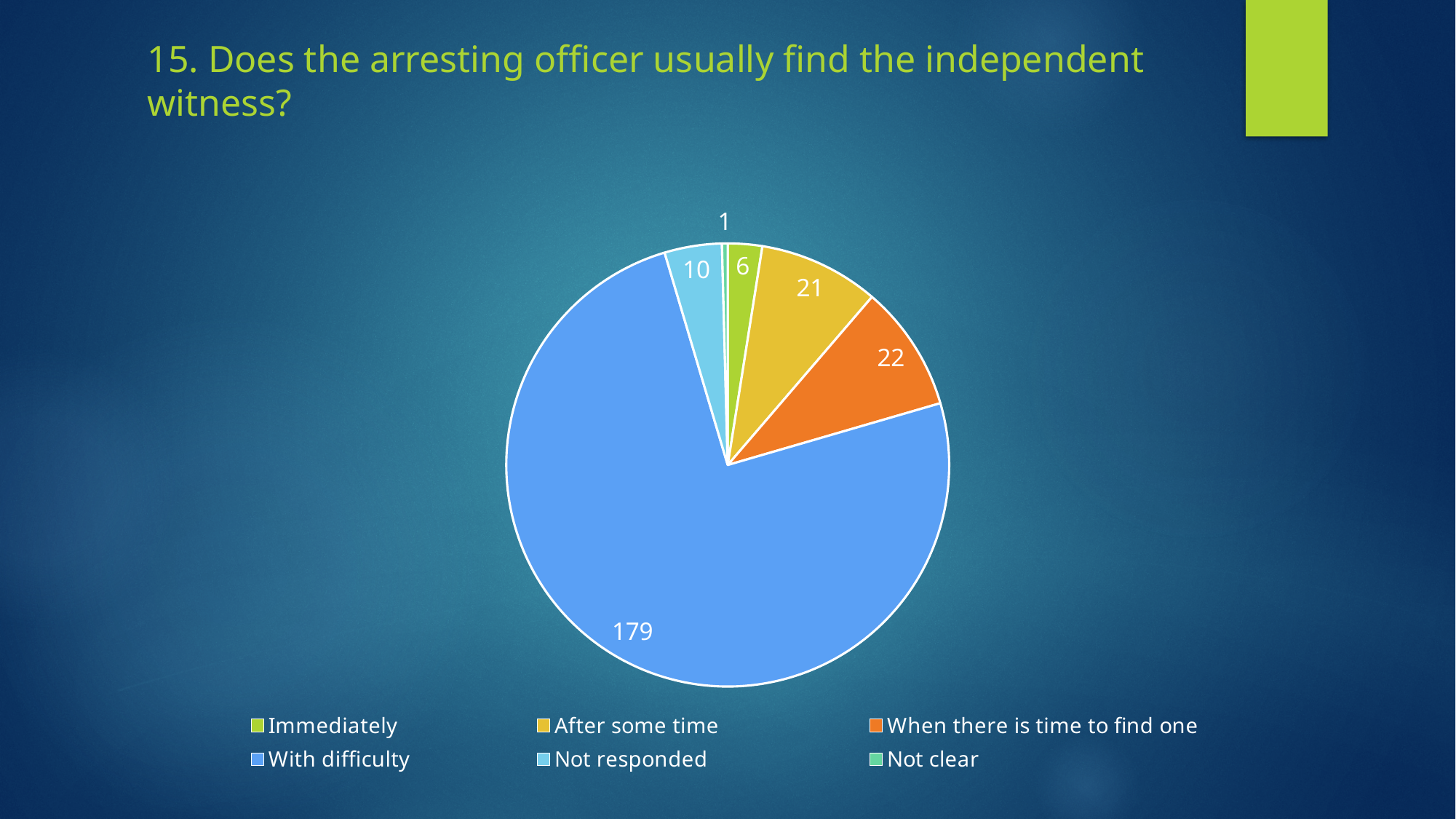
What is the value for "After some time"? 21 Which category has the largest slice of the pie? With difficulty What type of chart is shown on the slide? pie chart Which is larger, the value for "After some time" or the value for "When there is time to find one"? When there is time to find one What is the value for "Not responded"? 10 What is the difference between the values for "With difficulty" and "When there is time to find one"? 157 What is the total of all the slices in the pie chart? 239 What is the value for "Immediately"? 6 How many categories does the pie chart have? 6 What is the title of the chart on the slide? 15. Does the arresting officer usually find the independent witness? What is the value for "With difficulty"? 179 Which category has the smallest slice of the pie? Not clear